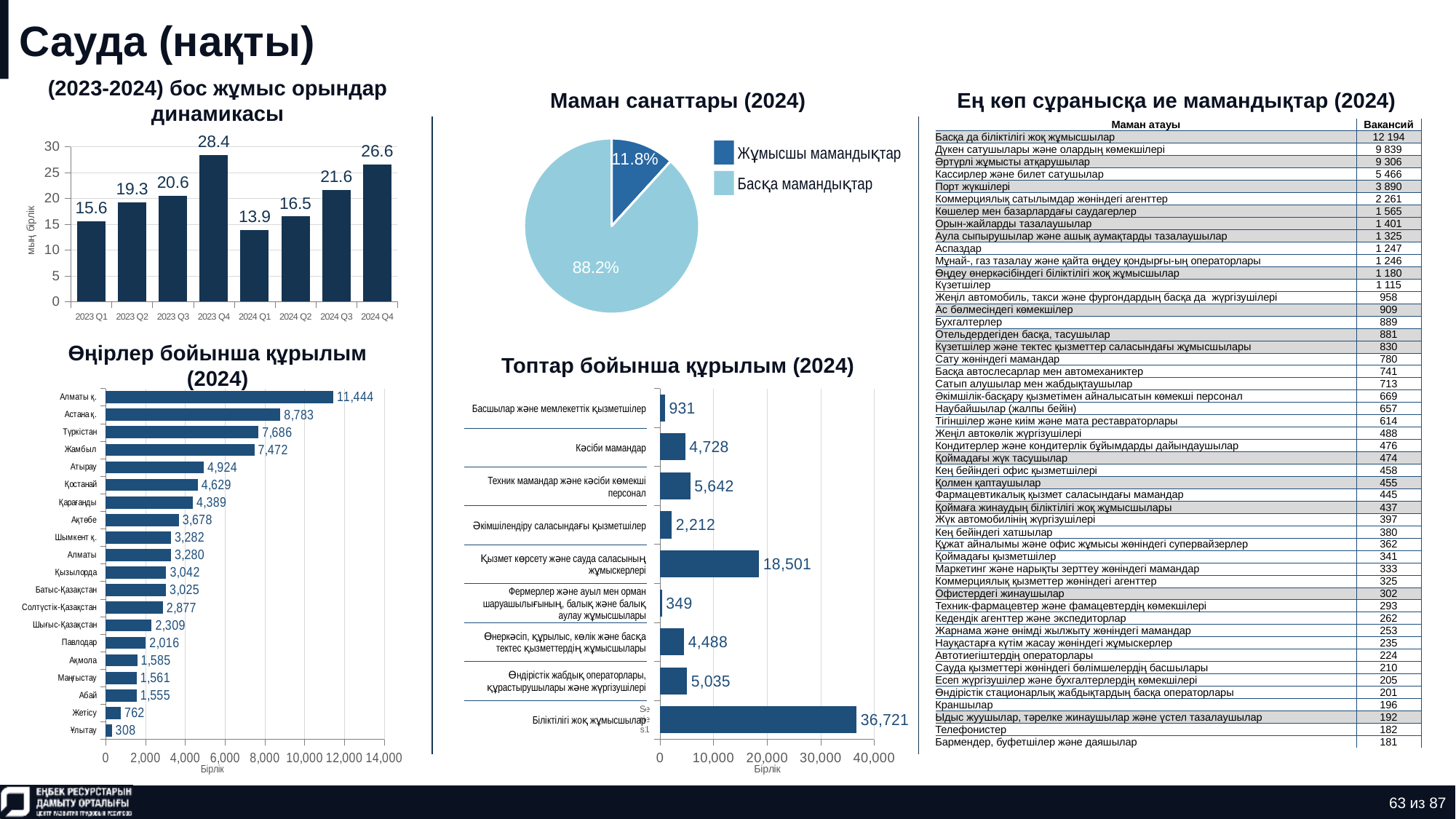
In the chart '(2023-2024) бос жұмыс орындар динамикасы', how many quarters are plotted? 8 In the chart 'Өңірлер бойынша құрылым (2024)', which is larger: Атырау or Қостанай? Атырау In the chart 'Өңірлер бойынша құрылым (2024)', what is the value for Астана қ.? 8,783 What type of chart is 'Топтар бойынша құрылым (2024)'? Bar chart In the chart '(2023-2024) бос жұмыс орындар динамикасы', which quarter has the lowest value? 2024 Q1 In the chart 'Өңірлер бойынша құрылым (2024)', which region has the highest value? Алматы қ. In the chart '(2023-2024) бос жұмыс орындар динамикасы', what is the value for 2023 Q4? 28.4 In the chart 'Топтар бойынша құрылым (2024)', which group has the lowest value? Фермерлер және ауыл мен орман шаруашылығының, балық және балық аулау жұмысшылары In the pie chart 'Маман санаттары (2024)', what share does 'Жұмысшы мамандықтар' have? 11.8% How many entries does the legend of the pie chart 'Маман санаттары (2024)' list? 2 In the chart 'Топтар бойынша құрылым (2024)', what is the value for 'Қызмет көрсету және сауда саласының жұмыскерлері'? 18,501 In the chart '(2023-2024) бос жұмыс орындар динамикасы', what is the difference between 2024 Q4 and 2024 Q3? 5.0